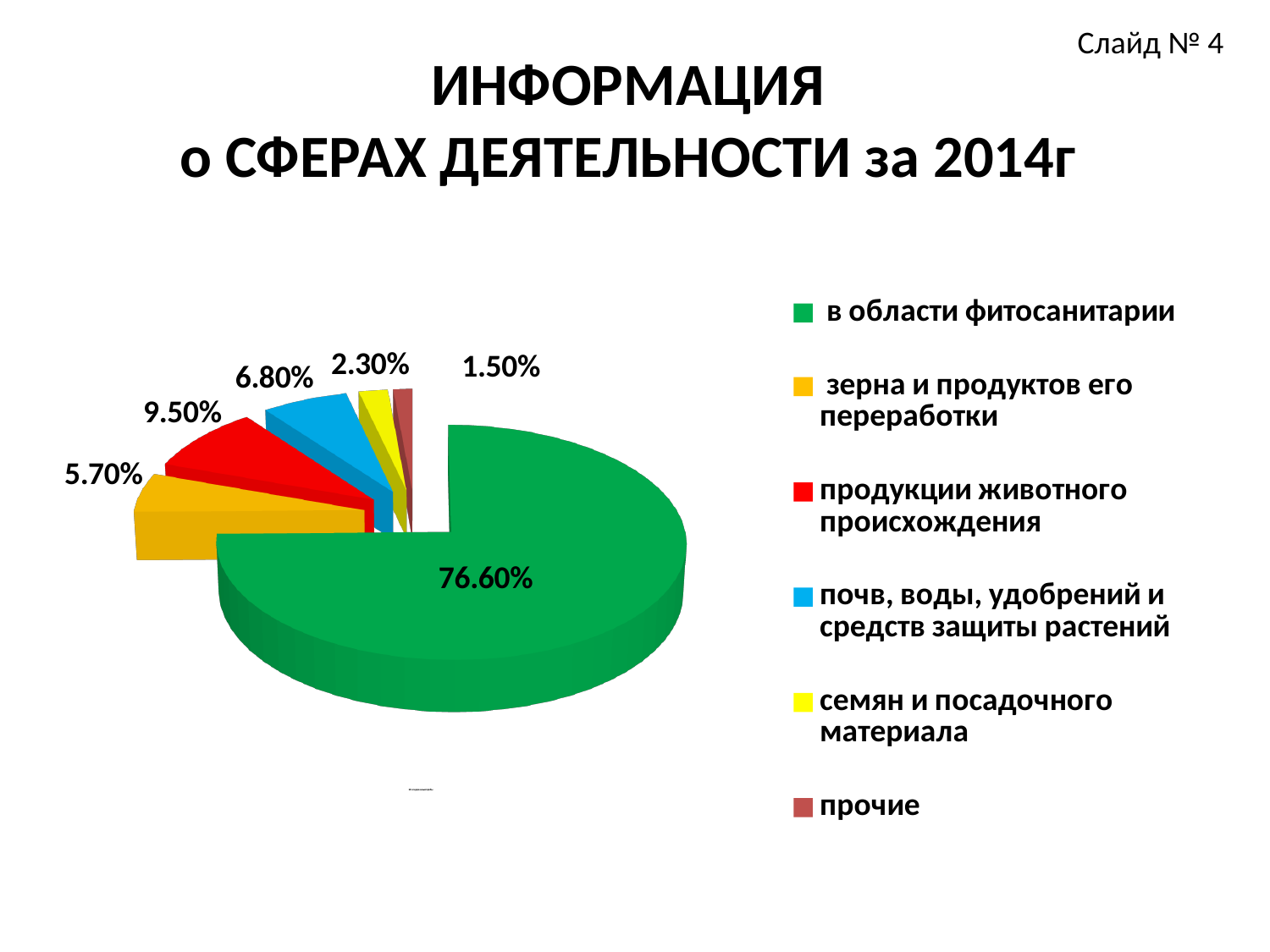
What is the value shown for "зерна и продуктов его переработки"? 5.70% What is the value shown for "почв, воды, удобрений и средств защиты растений"? 6.80% Which is larger: the slice for "продукции животного происхождения" or the slice for "почв, воды, удобрений и средств защиты растений"? продукции животного происхождения Which category has the largest slice of the pie? в области фитосанитарии How many categories does the legend list? 6 What kind of chart is shown on the slide? pie chart What is the difference between the values for "продукции животного происхождения" and "зерна и продуктов его переработки"? 3.80% What share of the pie does the slice for "в области фитосанитарии" have? 76.60% What is the value shown for "продукции животного происхождения"? 9.50% Which category has the smallest slice of the pie? прочие What is the value shown for "семян и посадочного материала"? 2.30% What is the value shown for "прочие"? 1.50%